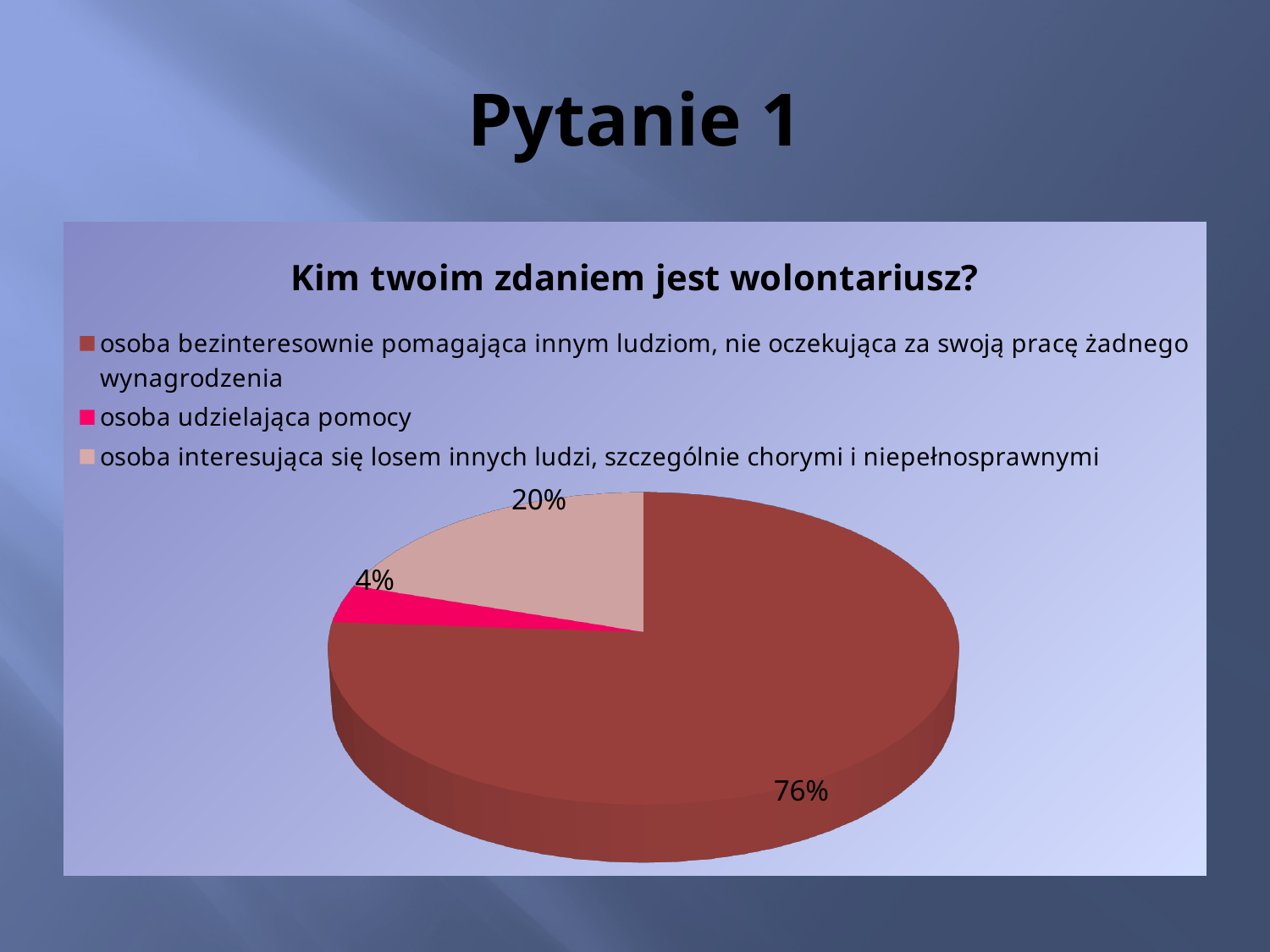
What share of the pie is labelled for "osoba interesująca się losem innych ludzi, szczególnie chorymi i niepełnosprawnymi"? 20% What is the difference in percentage points between the 20% slice and the 4% slice? 16 What is the difference in percentage points between the largest slice (76%) and the slice for "osoba interesująca się losem innych ludzi, szczególnie chorymi i niepełnosprawnymi" (20%)? 56 What share of the pie is labelled for "osoba udzielająca pomocy"? 4% What kind of chart is shown on the slide? pie chart Which is larger: the slice for "osoba udzielająca pomocy" or the slice for "osoba interesująca się losem innych ludzi, szczególnie chorymi i niepełnosprawnymi"? osoba interesująca się losem innych ludzi, szczególnie chorymi i niepełnosprawnymi Which category has the largest slice of the pie? osoba bezinteresownie pomagająca innym ludziom, nie oczekująca za swoją pracę żadnego wynagrodzenia What is the chart's title? Kim twoim zdaniem jest wolontariusz? How many categories does the legend list? 3 Which category has the smallest slice of the pie? osoba udzielająca pomocy What share of the pie is labelled for "osoba bezinteresownie pomagająca innym ludziom, nie oczekująca za swoją pracę żadnego wynagrodzenia"? 76% What colour is the slice for "osoba udzielająca pomocy"? pink